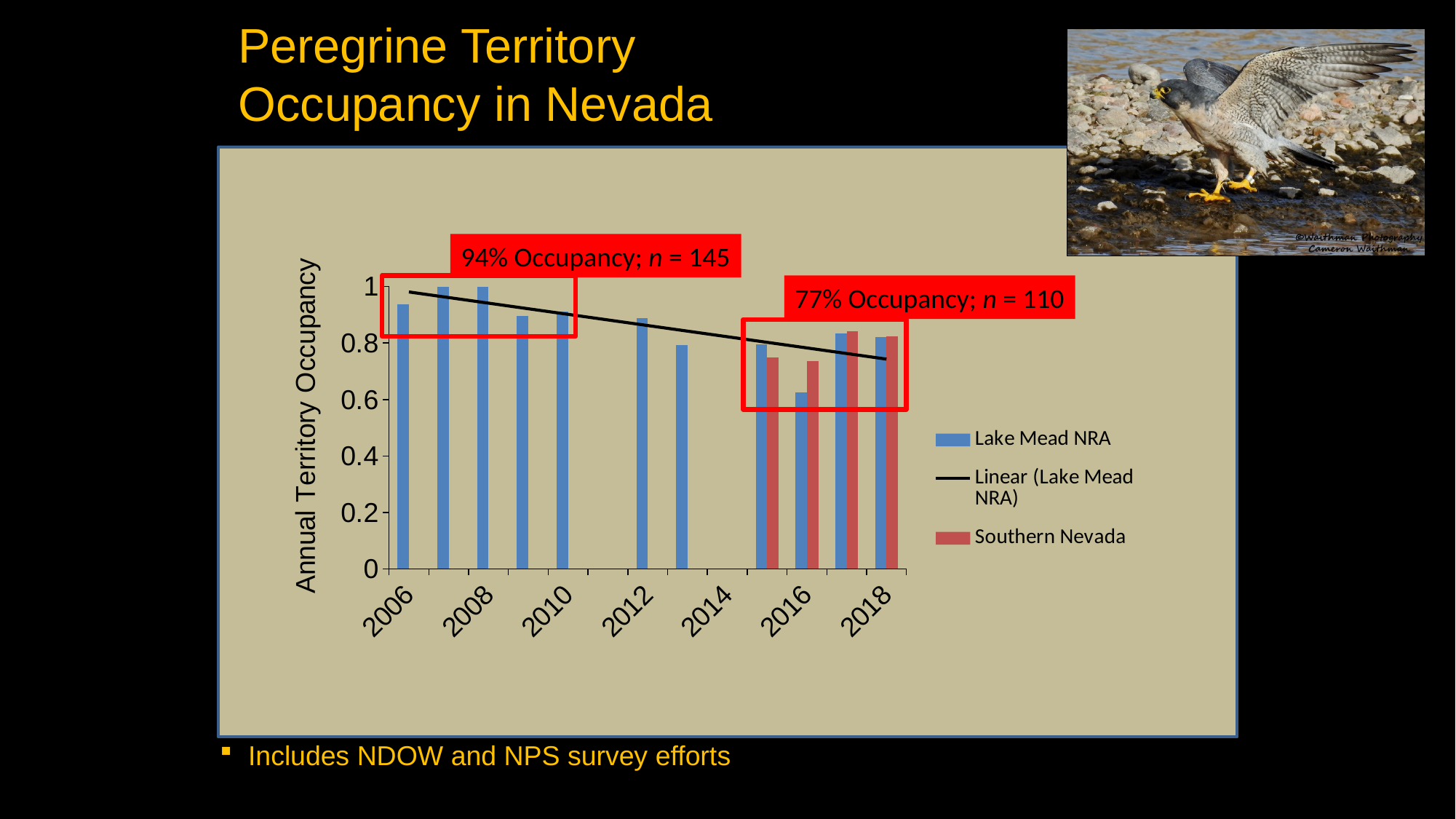
Is the Lake Mead NRA value for 2006 greater or less than 0.8? greater Is the Lake Mead NRA value for 2016 greater or less than 0.8? less Is the Lake Mead NRA value for 2012 greater or less than 0.8? greater What kind of chart is shown on the slide? Bar chart In 2016, which series has the larger value, Lake Mead NRA or Southern Nevada? Southern Nevada What is the label of the vertical axis? Annual Territory Occupancy In which year is the Lake Mead NRA bar the lowest? 2016 Which series is shown with blue bars? Lake Mead NRA Does the linear trend line for Lake Mead NRA rise or fall from 2006 to 2018? Fall How many entries does the chart legend list? 3 In which year does the Southern Nevada series first appear in the chart? 2015